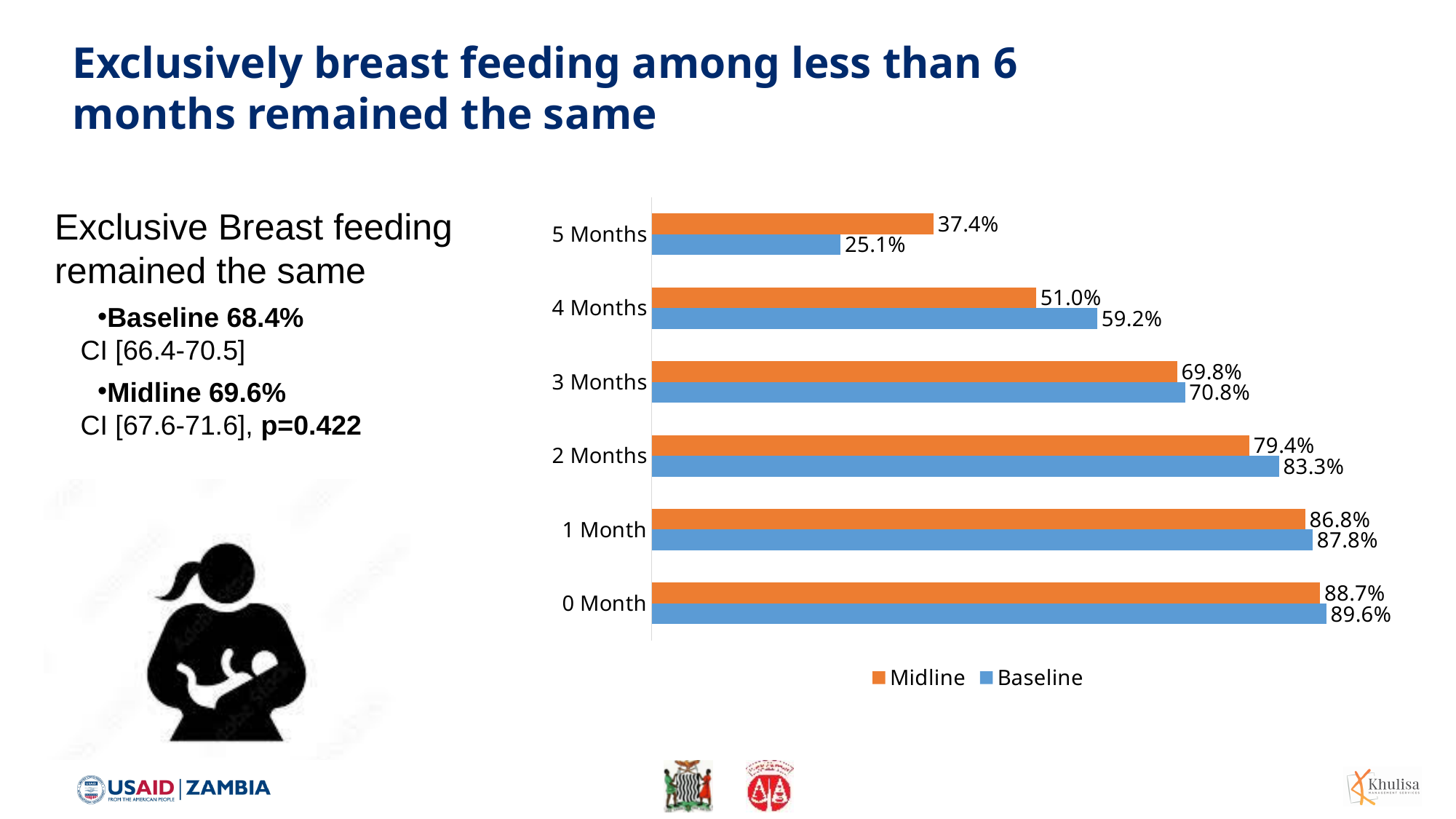
Which category has the lowest Baseline value? 5 Months What is the Baseline value for 0 Month? 89.6% What is the difference between the Baseline and Midline values for 4 Months? 8.2% What is the Baseline value for 4 Months? 59.2% How many age categories are shown on the chart? 6 For 2 Months, which is larger, the Midline value or the Baseline value? Baseline How many series does the legend list? 2 What is the difference between the Midline and Baseline values for 5 Months? 12.3% For 5 Months, which is larger, the Midline value or the Baseline value? Midline What kind of chart is shown on the slide? Bar chart Which category has the highest Midline value? 0 Month What is the Midline value for 5 Months? 37.4%